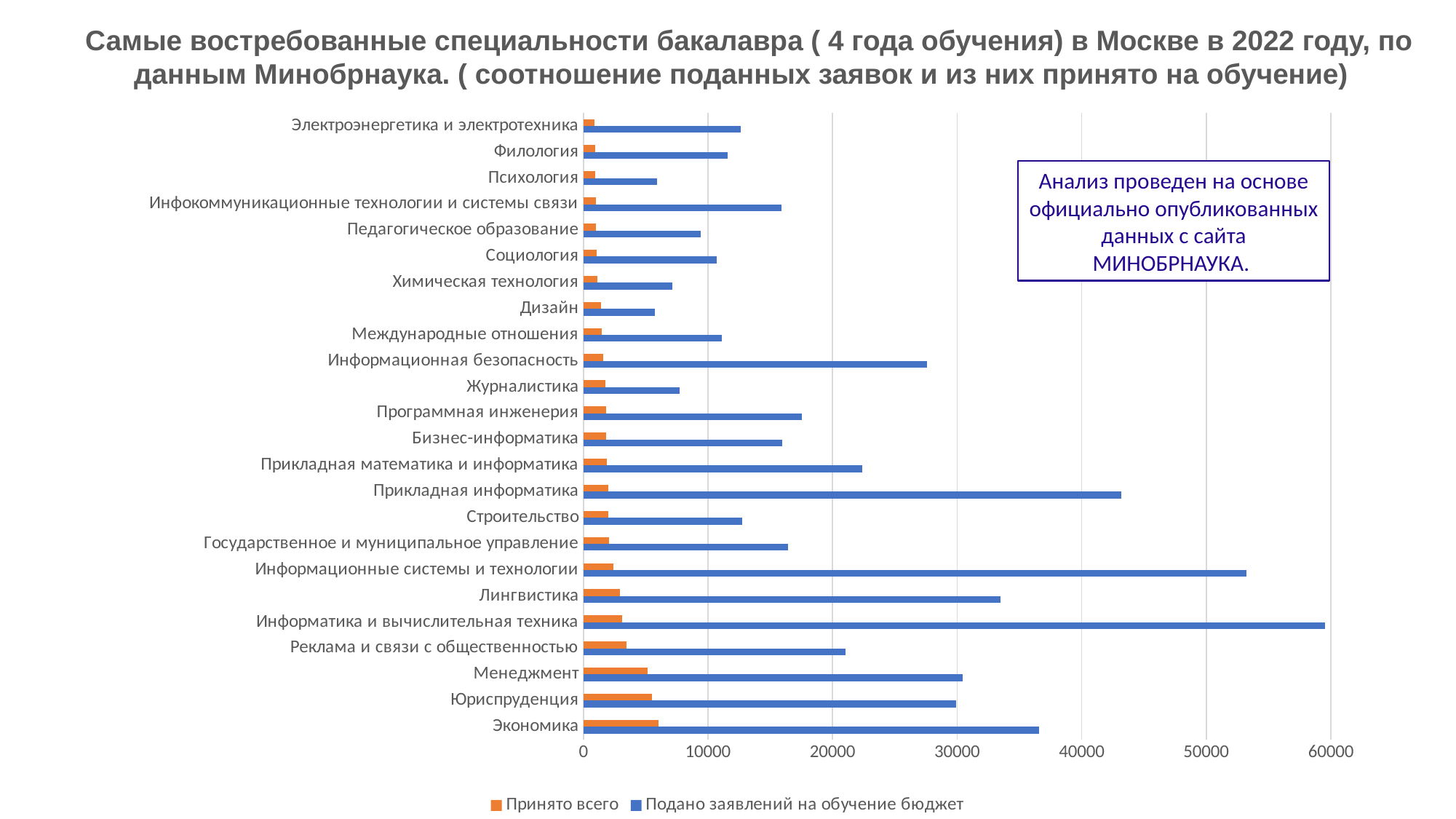
Is the "Подано заявлений на обучение бюджет" value for Психология greater or less than 10000? less Which has a larger "Подано заявлений на обучение бюджет" value: Экономика or Менеджмент? Экономика Is the "Подано заявлений на обучение бюджет" value for Информационные системы и технологии greater or less than 50000? greater Which colour represents the series "Принято всего" in the chart? Orange Is the "Подано заявлений на обучение бюджет" value for Информационная безопасность greater or less than 30000? less What kind of chart is shown on the slide? Bar chart How many specialties (categories) are plotted on the chart? 24 What is the name of the series shown in blue in the legend? Подано заявлений на обучение бюджет How many series does the legend list? 2 Which has a larger "Подано заявлений на обучение бюджет" value: Прикладная информатика or Лингвистика? Прикладная информатика Which specialty has the highest value for "Подано заявлений на обучение бюджет"? Информатика и вычислительная техника